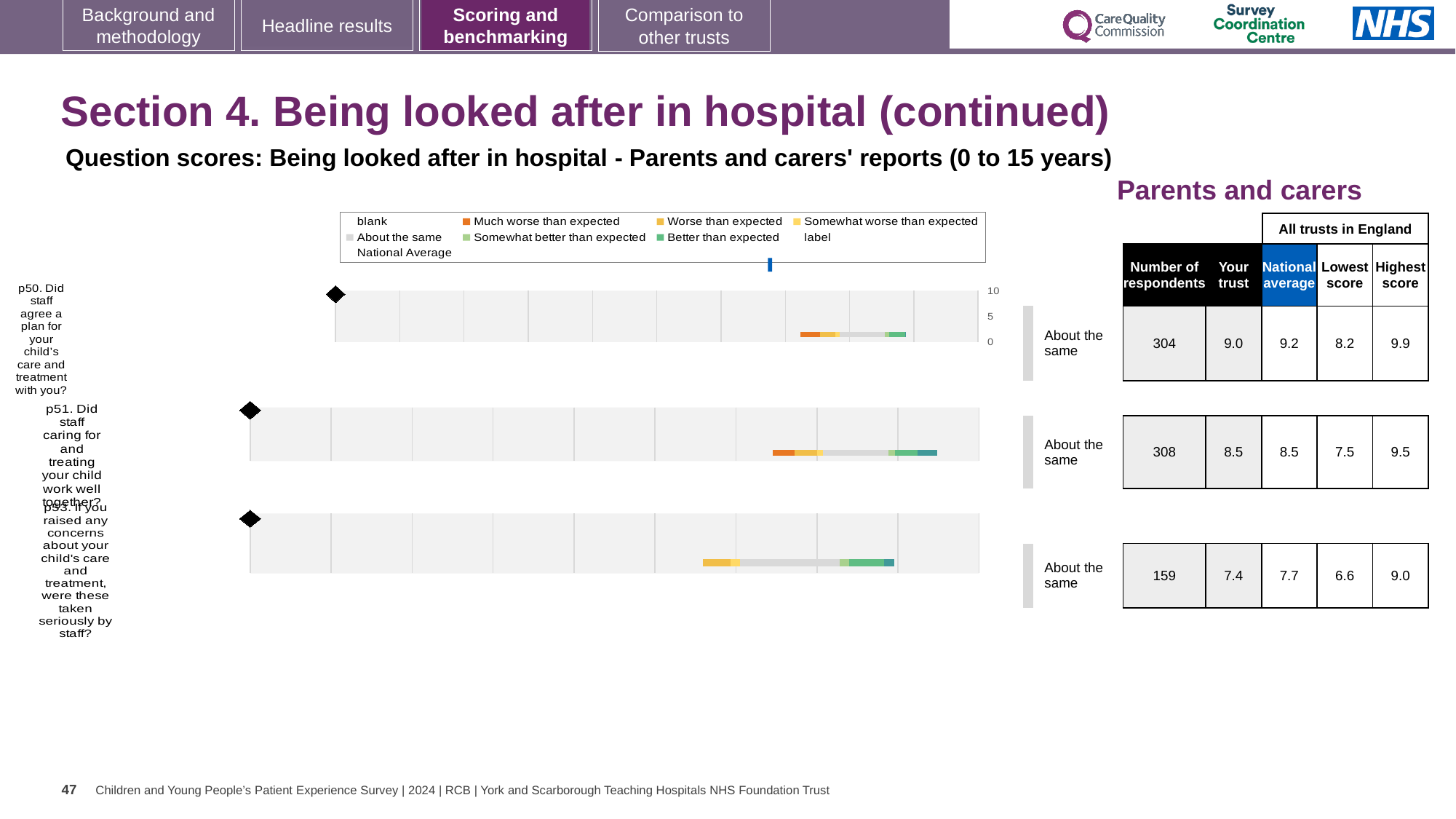
Which question has the lowest number of respondents? p53 What type of chart is used to show the benchmark ranges for each question? Bar chart What is the national average score for p53 (If you raised any concerns about your child's care and treatment, were these taken seriously by staff?)? 7.7 How many survey questions are charted on this slide? 3 For p50, which is larger: the 'Your trust' score or the national average? National average Is the 'Your trust' score for p53 greater or less than 5? greater Which question has the highest 'Your trust' score? p50 What benchmark category is shown for p53? About the same In the legend, what colour represents 'Much worse than expected'? Orange For p50, what is the difference between the highest score and the lowest score across all trusts in England? 1.7 What is the 'Your trust' score for p50 (Did staff agree a plan for your child's care and treatment with you?)? 9.0 How many respondents answered p51 (Did staff caring for and treating your child work well together?)? 308